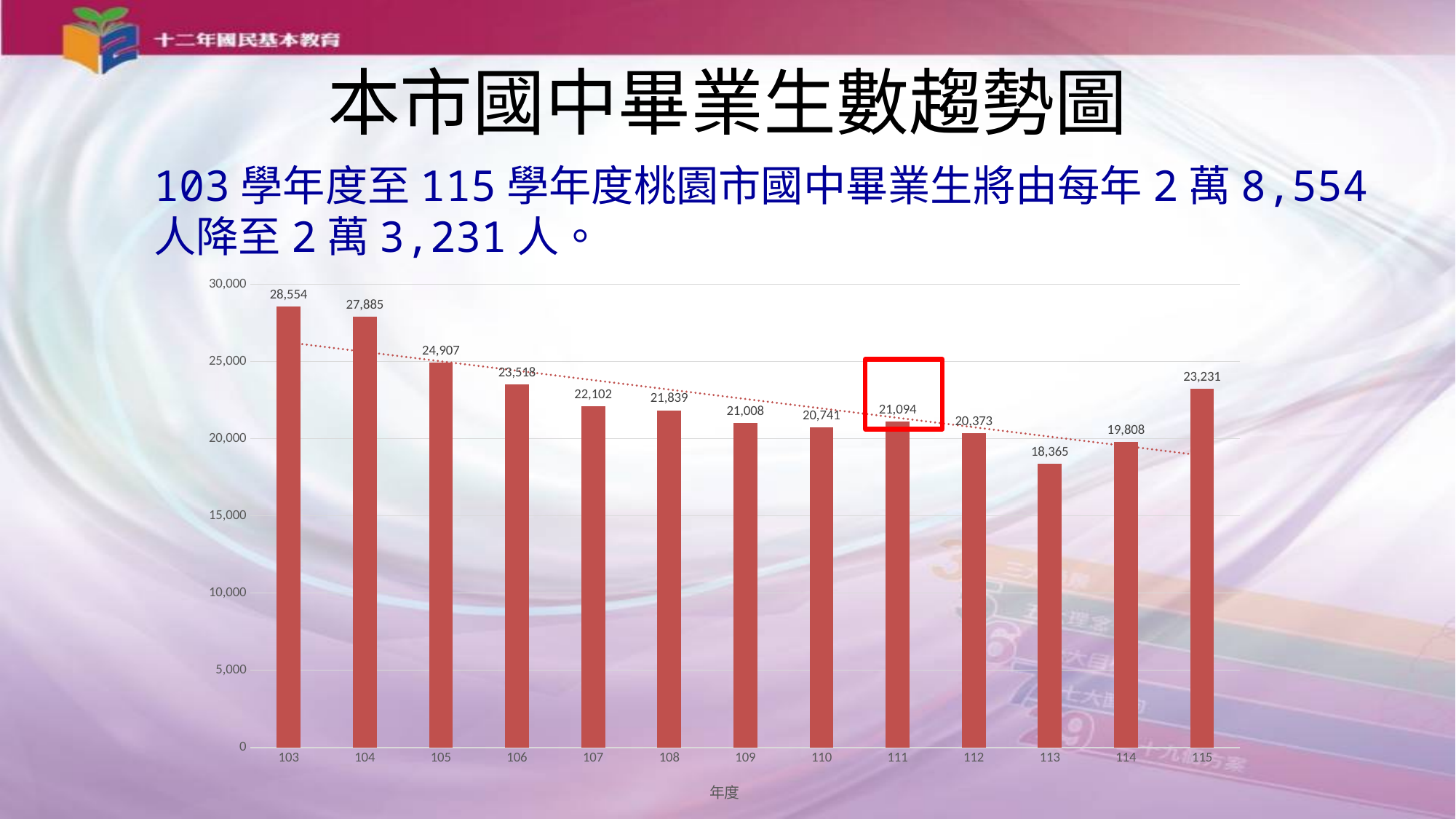
What is the difference between the values for year 114 and year 113? 1,443 What is the value for year 111? 21,094 Is the value for year 105 greater or less than 25,000? less What kind of chart is shown on the slide? bar chart What is the label of the x axis? 年度 What is the value for year 113? 18,365 How many years are shown on the x axis? 13 Which year has the lowest value? 113 What is the difference between the values for year 103 and year 115? 5,323 Which year has the highest value? 103 What is the value for year 103? 28,554 Which is larger, the value for year 111 or the value for year 112? 111